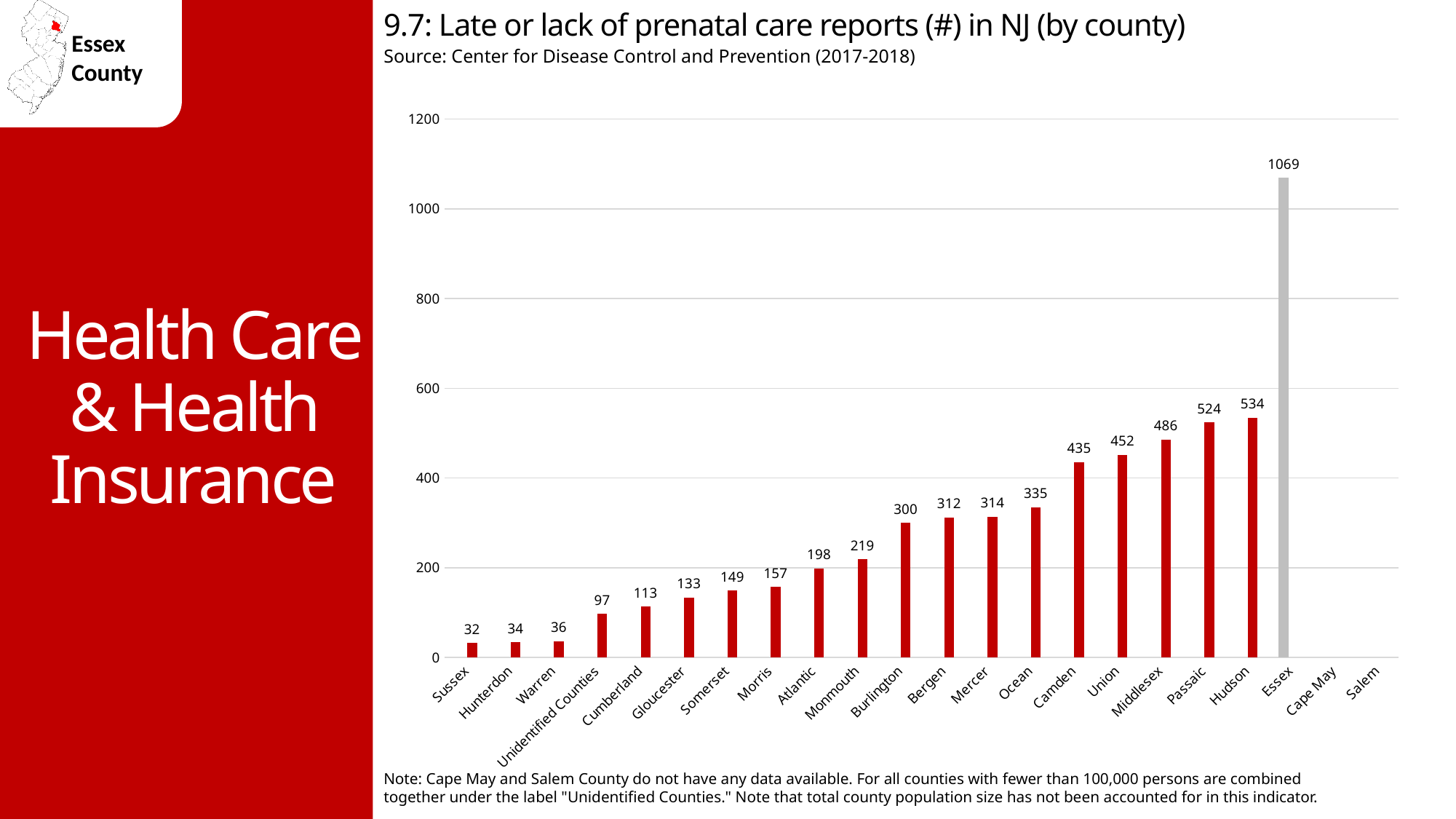
What is the difference between the values for Hudson and Passaic? 10 Do the values generally rise or fall moving from left to right along the x axis? Rise Which has a higher value, Bergen or Mercer? Mercer What kind of chart is shown on the slide? Bar chart How many late or lack of prenatal care reports are shown for Essex County? 1069 Is the value for Essex greater or less than 1000? greater Which county has the highest number of late or lack of prenatal care reports? Essex How many county labels are listed along the x axis? 22 What value is shown for the 'Unidentified Counties' bar? 97 Which county has the lowest value shown on the chart? Sussex What is the difference between the values for Essex and Hudson? 535 What is the value shown for Camden? 435